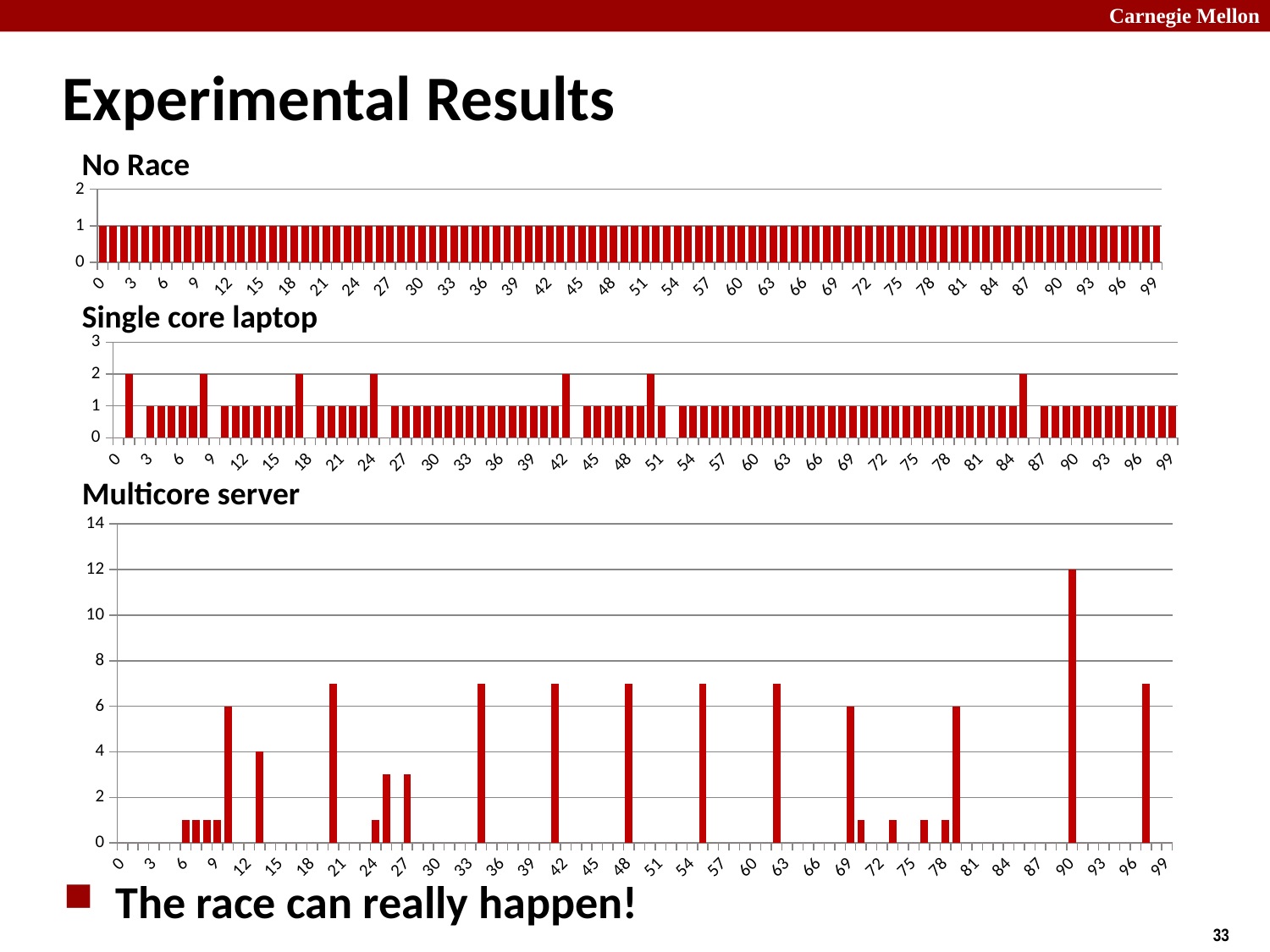
In the Single core laptop chart, is the value at x = 42 greater or less than 3? less Which chart has the taller maximum bar, Single core laptop or Multicore server? Multicore server In the No Race chart, what value does every bar reach? 1 What is the highest tick shown on the y axis of the Multicore server chart? 14 In the Single core laptop chart, what is the highest value reached by any bar? 2 In the Multicore server chart, at which x value does the tallest bar occur? 90 How many charts are shown on the slide? 3 In the No Race chart, do the values rise, fall, or stay flat across the x axis? stay flat In the Multicore server chart, what is the highest value reached by any bar? 12 What kind of chart is the Multicore server chart? bar chart In the Multicore server chart, is the value at x = 90 greater or less than 10? greater In the Single core laptop chart, what is the value at x = 42? 2